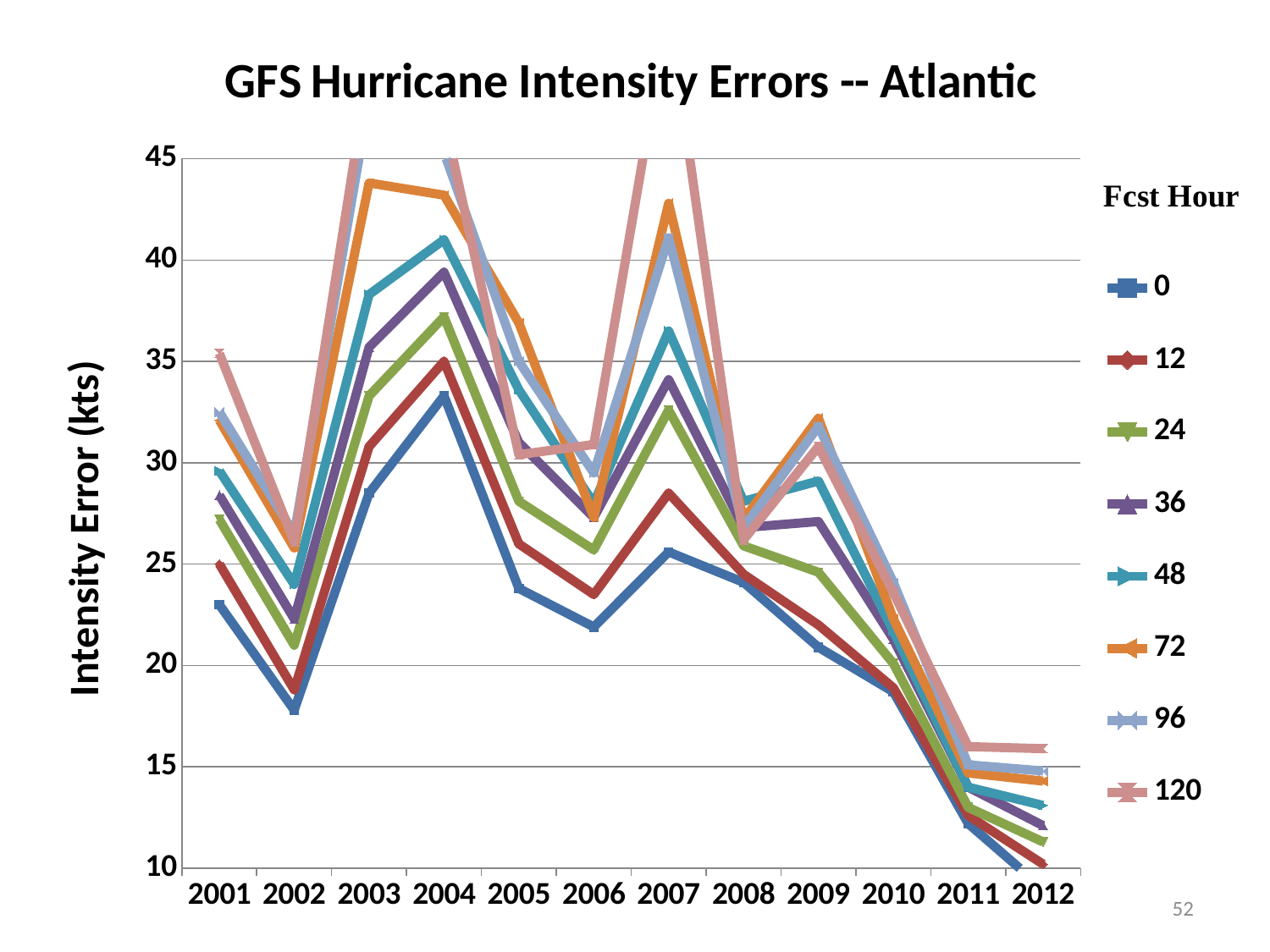
How many series does the legend list? 8 How many years are plotted along the x axis? 12 In which year does the 0 forecast hour series reach its highest value? 2004 For the 72 forecast hour series, which year has the larger value, 2007 or 2008? 2007 Is the value for the 120 forecast hour series in 2012 greater or less than 20? less Is the value for the 0 forecast hour series in 2004 greater or less than 30? greater From 2009 to 2012, does the 0 forecast hour series rise or fall? fall Is the value for the 0 forecast hour series in 2002 greater or less than 20? less In which year does the 0 forecast hour series reach its lowest value? 2012 What is the title shown above the legend? Fcst Hour What kind of chart is shown on the slide? line chart What is the title of the chart? GFS Hurricane Intensity Errors -- Atlantic